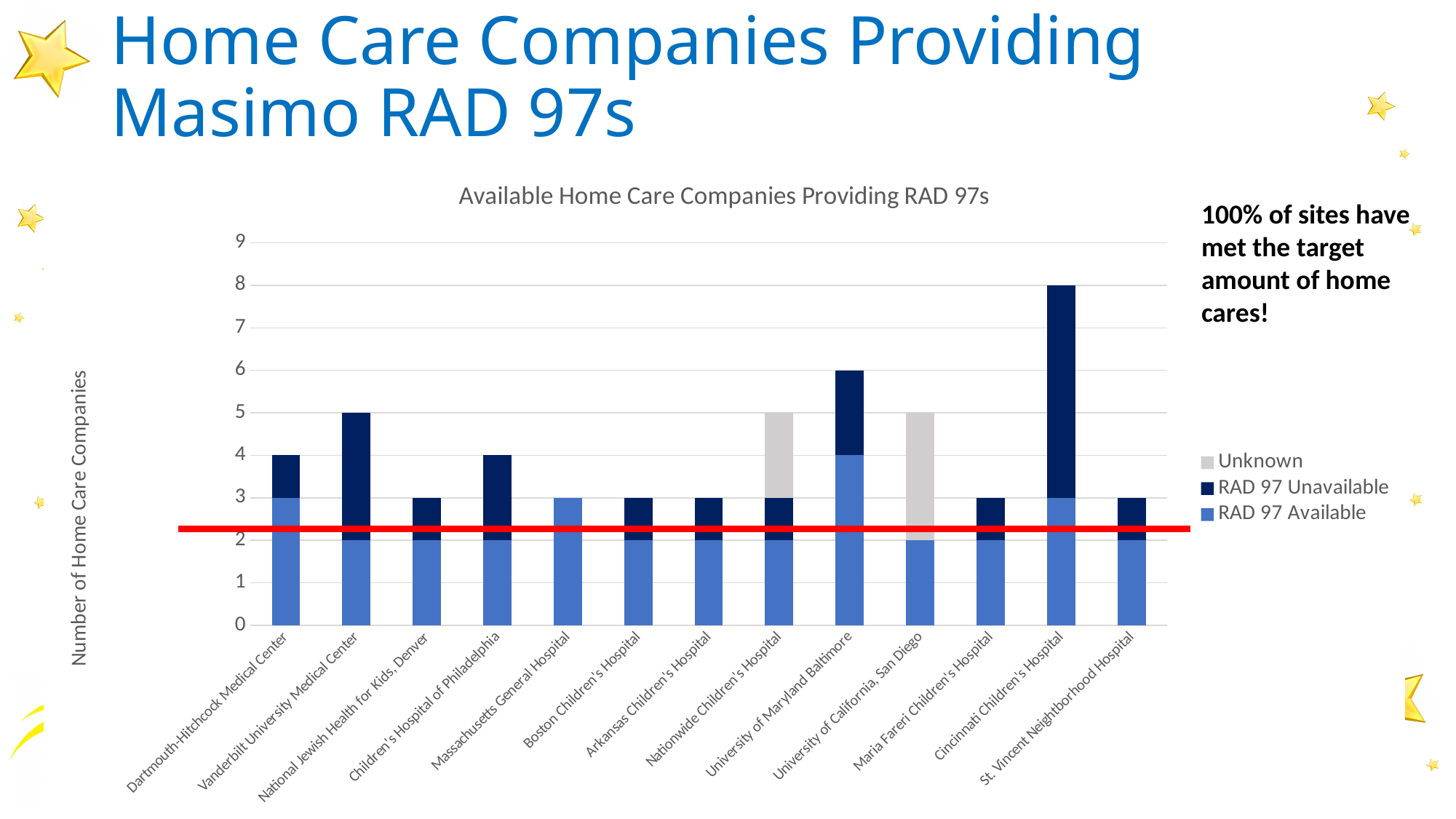
How many hospitals (categories) are shown on the x axis? 13 Which hospital has the tallest stacked bar (most home care companies in total)? Cincinnati Children's Hospital What is the label of the y axis? Number of Home Care Companies How many series does the legend list? 3 Which hospital has the largest RAD 97 Available segment? University of Maryland Baltimore What kind of chart is shown on the slide? Stacked bar chart Which is larger, the total bar for Dartmouth-Hitchcock Medical Center or the total bar for Cincinnati Children's Hospital? Cincinnati Children's Hospital Is the total for Vanderbilt University Medical Center greater or less than 4? greater Is the total for Massachusetts General Hospital greater or less than 4? less What is the total height of the stacked bar for University of Maryland Baltimore? 6 What is the title of the chart? Available Home Care Companies Providing RAD 97s What is the total height of the stacked bar for Cincinnati Children's Hospital? 8